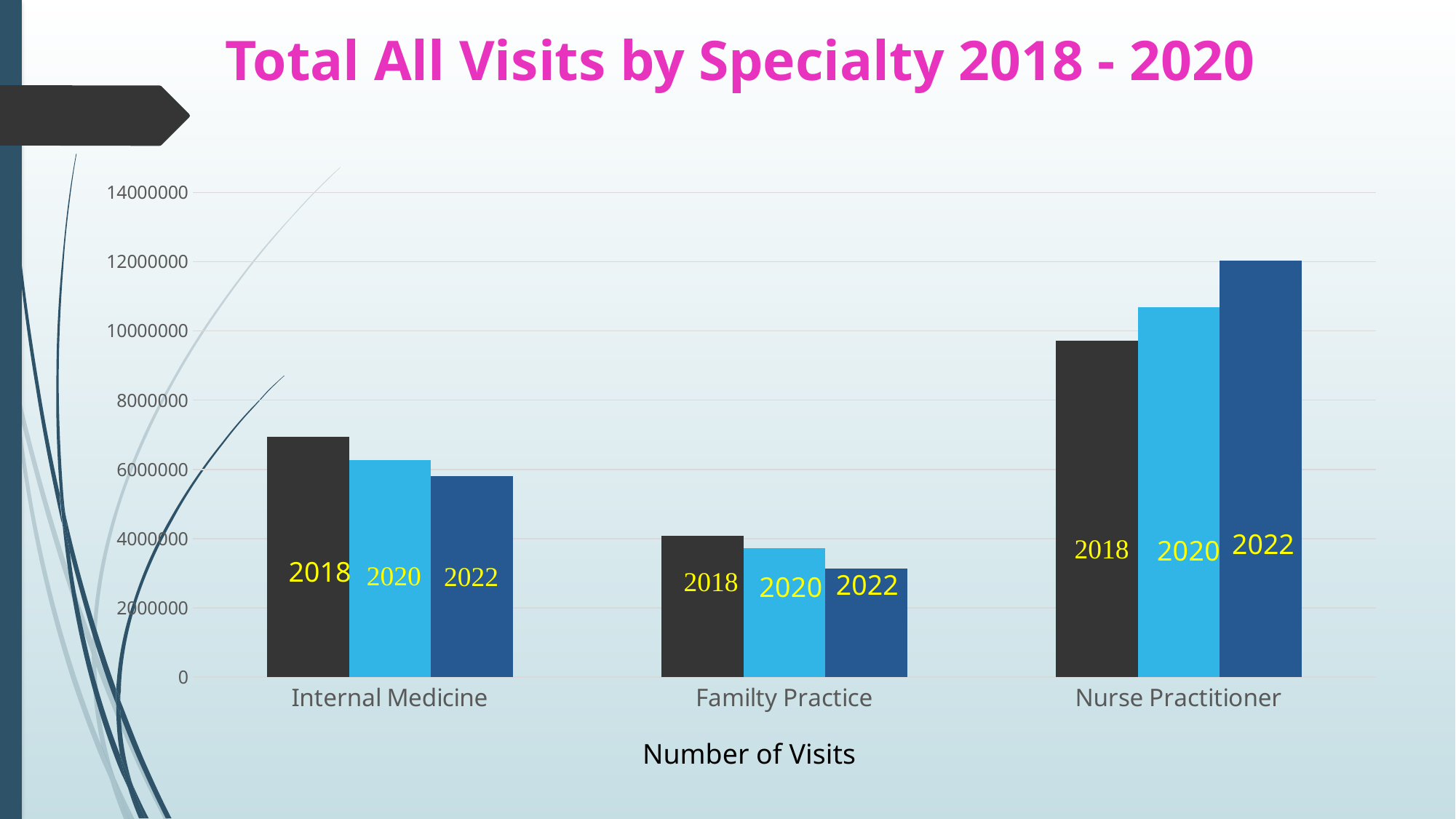
Which is larger: Internal Medicine in 2020 or Familty Practice in 2020? Internal Medicine in 2020 Do the visits for Nurse Practitioner rise or fall from 2018 to 2022? rise What is the title of the chart? Total All Visits by Specialty 2018 - 2020 Which specialty has the highest number of visits in 2022? Nurse Practitioner Which specialty has the lowest number of visits in 2018? Familty Practice Is the value for Nurse Practitioner in 2018 greater or less than 8000000? greater Do the visits for Internal Medicine rise or fall from 2018 to 2022? fall Is the value for Familty Practice in 2022 greater or less than 4000000? less What kind of chart is shown on the slide? bar chart How many specialty categories are shown on the x axis? 3 Is the value for Internal Medicine in 2018 greater or less than 6000000? greater What is the label shown below the x axis? Number of Visits